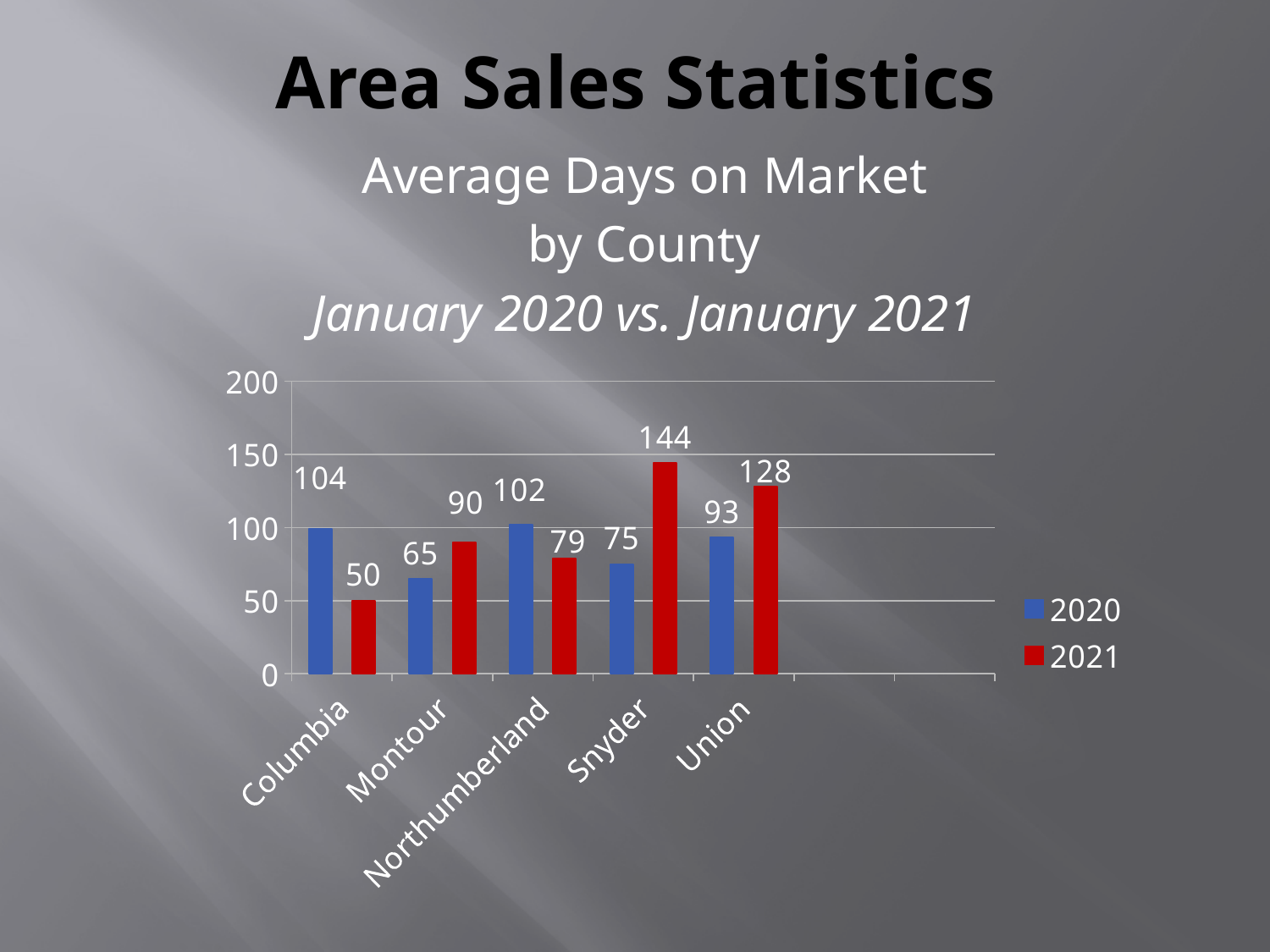
What is the 2020 value for Columbia? 104 How many series does the legend list? 2 What is the 2021 value for Snyder? 144 What is the difference between the 2021 and 2020 values for Union? 35 What kind of chart is shown? bar chart Which county has the highest 2021 value? Snyder How many counties are shown on the x axis? 5 Which colour represents the 2021 series? red Which is larger for Northumberland, the 2020 value or the 2021 value? 2020 What is the 2021 value for Montour? 90 Which county has the lowest 2020 value? Montour Is the 2021 value for Columbia greater or less than 100? less